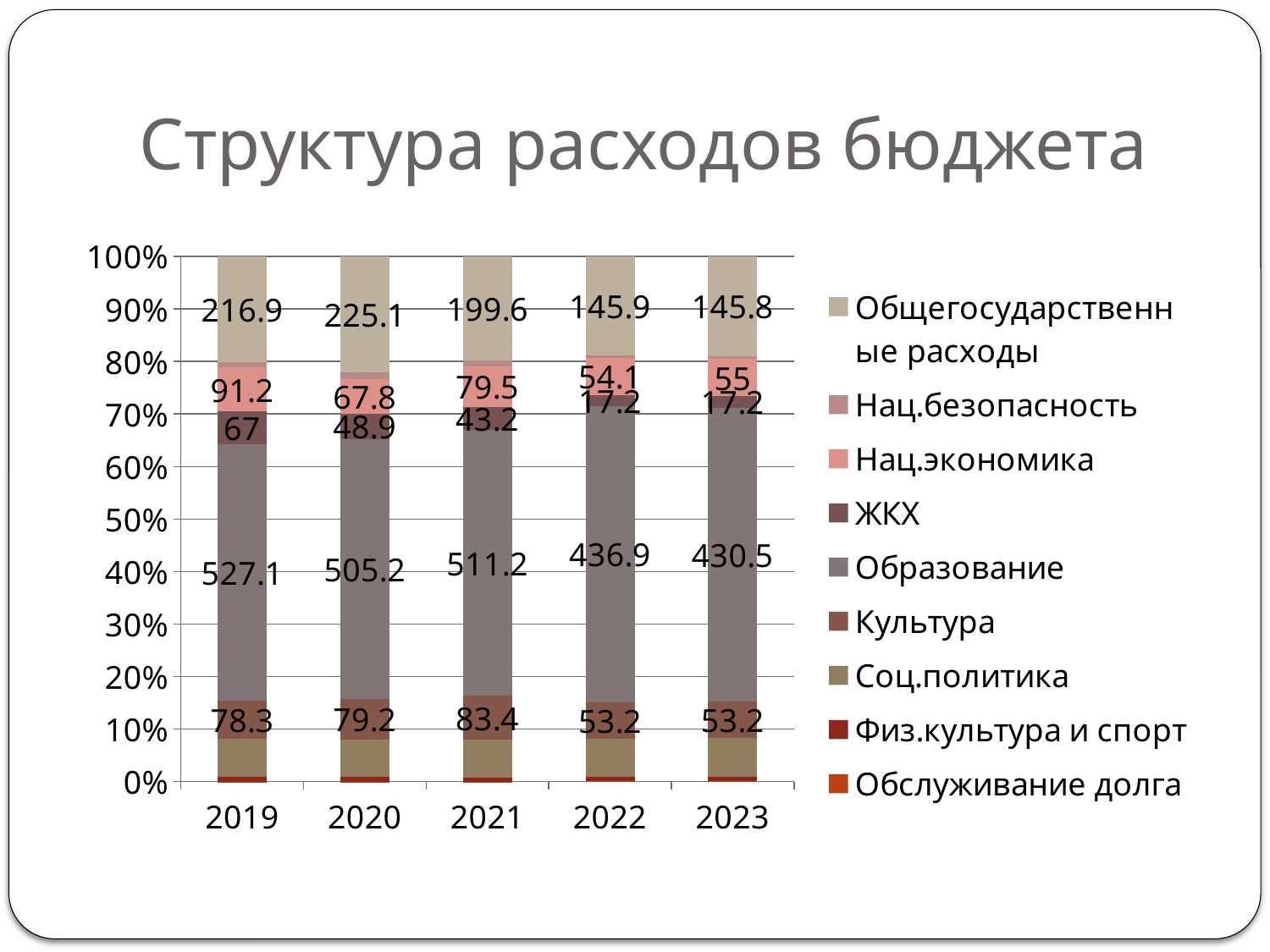
Do the labelled values for ЖКХ rise or fall from 2019 to 2023? fall What is the value labelled for Образование in 2019? 527.1 How many series does the chart's legend list? 9 What kind of chart is shown on the slide? bar chart What is the value labelled for ЖКХ in 2020? 48.9 How many years are shown on the x axis of the chart? 5 Which year has the larger labelled value for Нац.экономика, 2020 or 2021? 2021 What is the title of the chart? Структура расходов бюджета In which year is the labelled value for Образование the highest? 2019 What is the value labelled for Нац.экономика in 2022? 54.1 What is the difference between the Общегосударственные расходы values for 2020 and 2019? 8.2 What is the value labelled for Общегосударственные расходы in 2021? 199.6